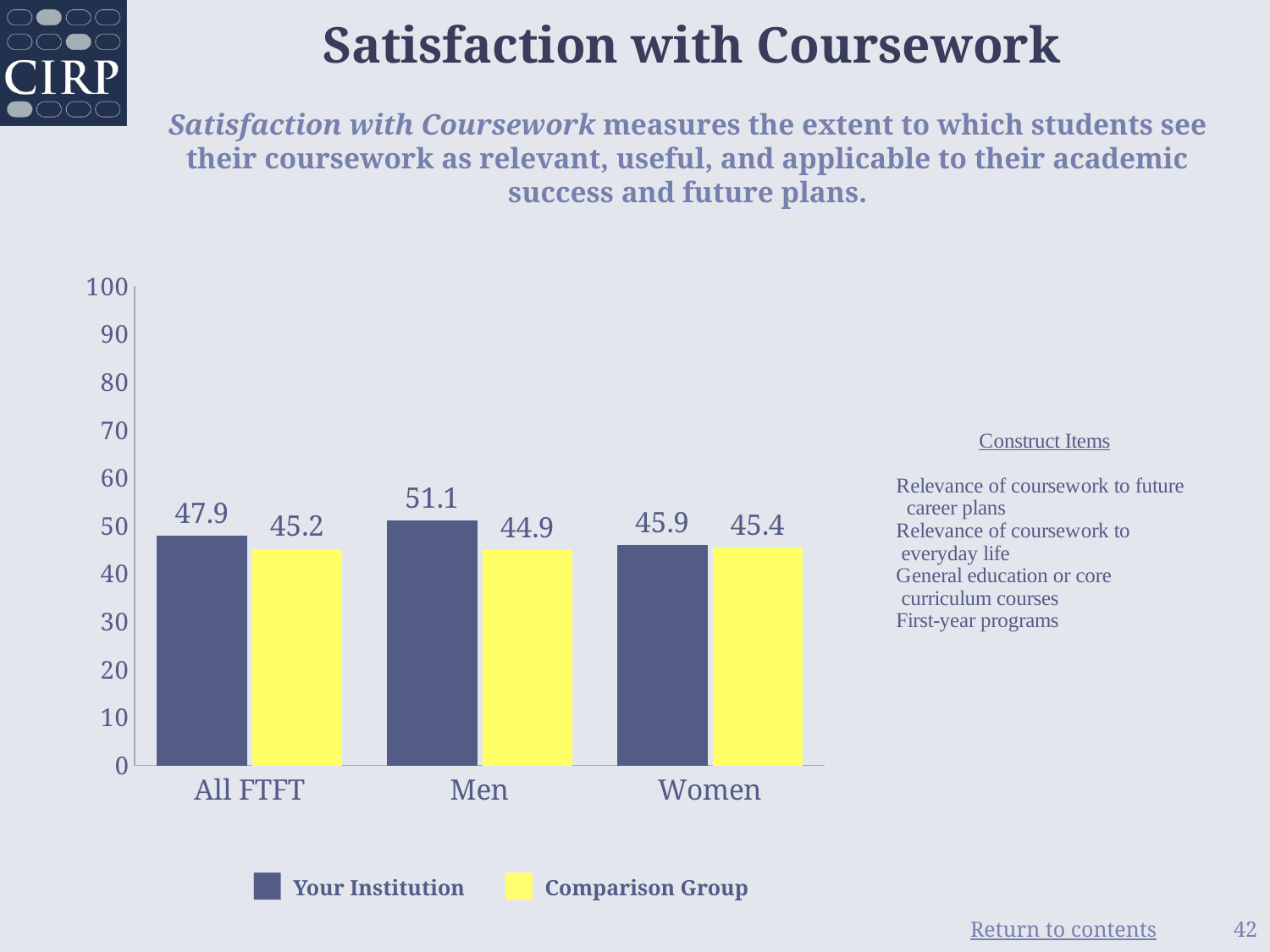
What is the difference between Your Institution and the Comparison Group in the Men category? 6.2 Which is larger in the All FTFT category: Your Institution or the Comparison Group? Your Institution How many series does the legend list? 2 What kind of chart is shown on the slide? Bar chart Which category has the highest value for Your Institution? Men What is the value for the Comparison Group in the Men category? 44.9 How many categories are shown on the x axis? 3 What is the value for the Comparison Group in the Women category? 45.4 Is the value for Your Institution in the Men category greater or less than 50? greater Which category has the lowest value for the Comparison Group? Men What is the value for Your Institution in the Women category? 45.9 What is the value for Your Institution in the All FTFT category? 47.9